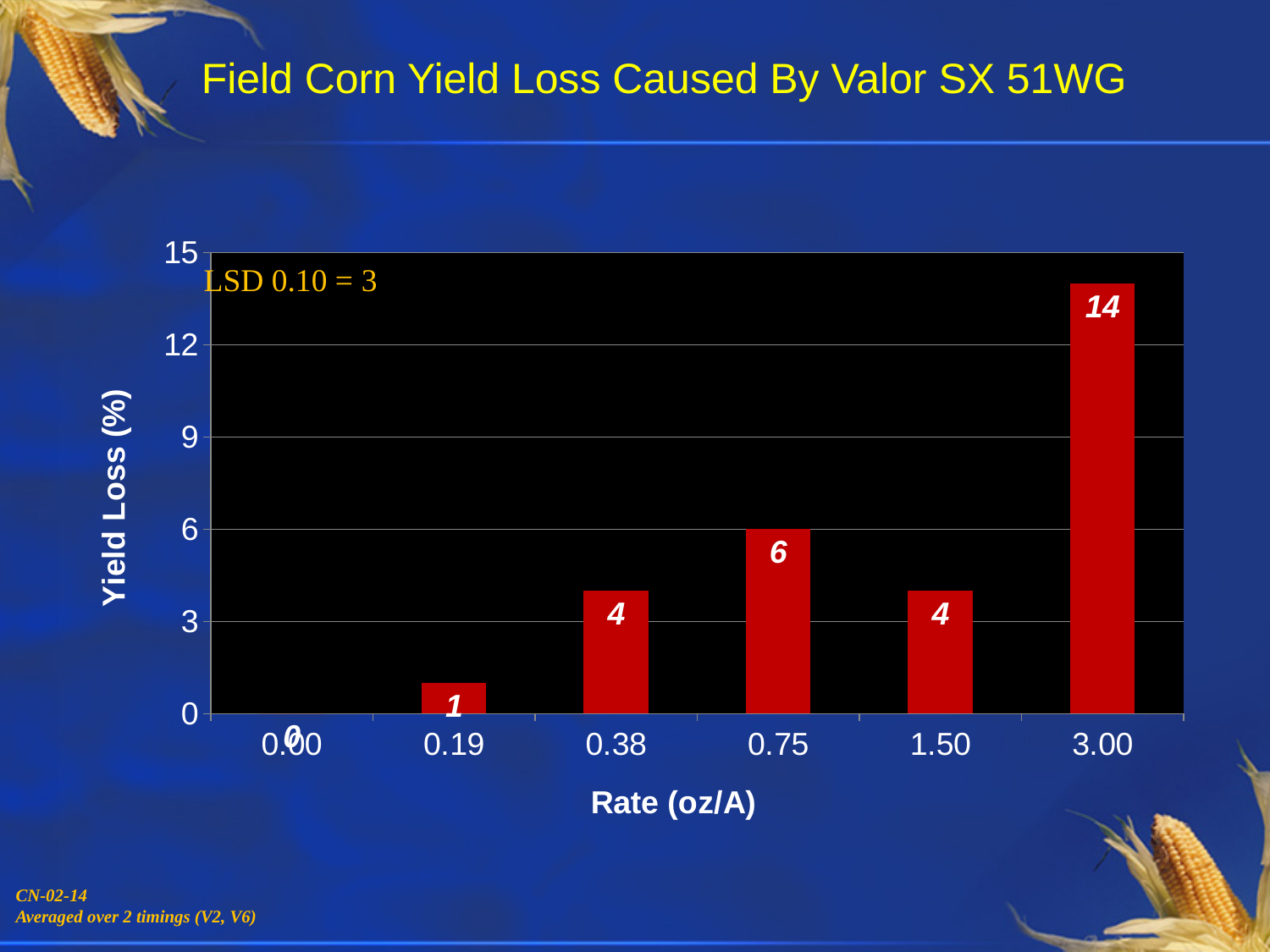
Is the yield loss at the 3.00 oz/A rate greater or less than 12? greater What is the yield loss at the 0.19 oz/A rate? 1 Which rate has the highest yield loss? 3.00 What is the title of the chart? Field Corn Yield Loss Caused By Valor SX 51WG What is the label of the y axis? Yield Loss (%) Which has a larger yield loss, the 0.75 oz/A rate or the 1.50 oz/A rate? 0.75 What is the yield loss at the 0.75 oz/A rate? 6 What is the yield loss at the 3.00 oz/A rate? 14 What is the difference in yield loss between the 3.00 and 0.75 oz/A rates? 8 What kind of chart is shown on the slide? bar chart What is the yield loss at the 0.00 oz/A rate? 0 How many rate categories are shown on the x axis? 6